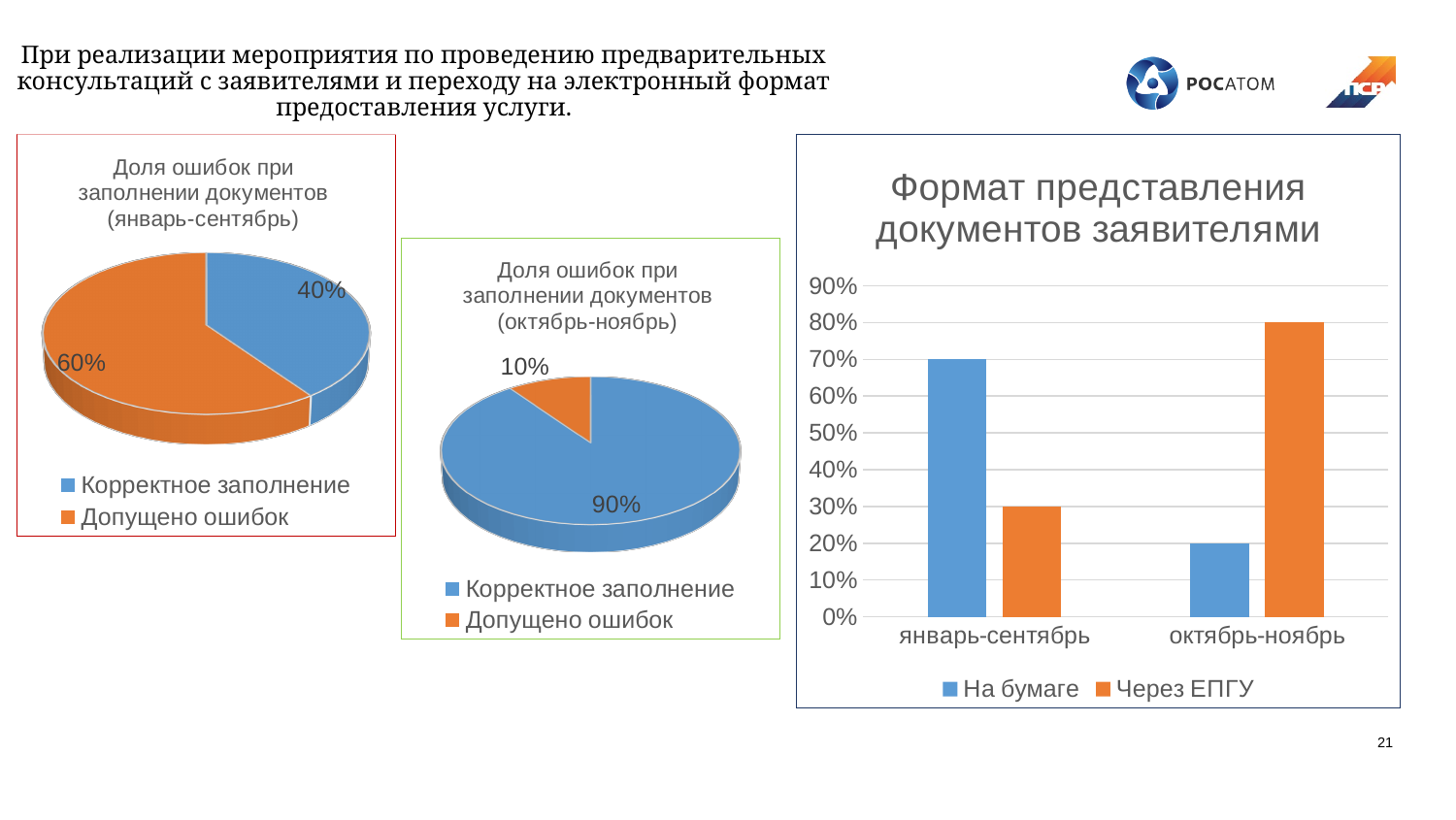
In the pie chart 'Доля ошибок при заполнении документов (октябрь-ноябрь)', what share is 'Допущено ошибок'? 10% In the pie chart 'Доля ошибок при заполнении документов (октябрь-ноябрь)', which slice is the largest? Корректное заполнение In the pie chart 'Доля ошибок при заполнении документов (январь-сентябрь)', what share is 'Допущено ошибок'? 60% In the chart 'Формат представления документов заявителями', what is the value for 'На бумаге' in 'январь-сентябрь'? 70% In the chart 'Формат представления документов заявителями', what is the value for 'Через ЕПГУ' in 'октябрь-ноябрь'? 80% In the chart 'Формат представления документов заявителями', which is larger in 'октябрь-ноябрь': 'На бумаге' or 'Через ЕПГУ'? Через ЕПГУ In the chart 'Формат представления документов заявителями', is the value for 'Через ЕПГУ' in 'январь-сентябрь' greater or less than 50%? less In the pie chart 'Доля ошибок при заполнении документов (январь-сентябрь)', which slice is the smallest? Корректное заполнение In the chart 'Формат представления документов заявителями', how many series does the legend list? 2 In the pie chart 'Доля ошибок при заполнении документов (январь-сентябрь)', what share is 'Корректное заполнение'? 40% What kind of chart is 'Формат представления документов заявителями'? Bar chart How many slices does the pie chart 'Доля ошибок при заполнении документов (октябрь-ноябрь)' have? 2